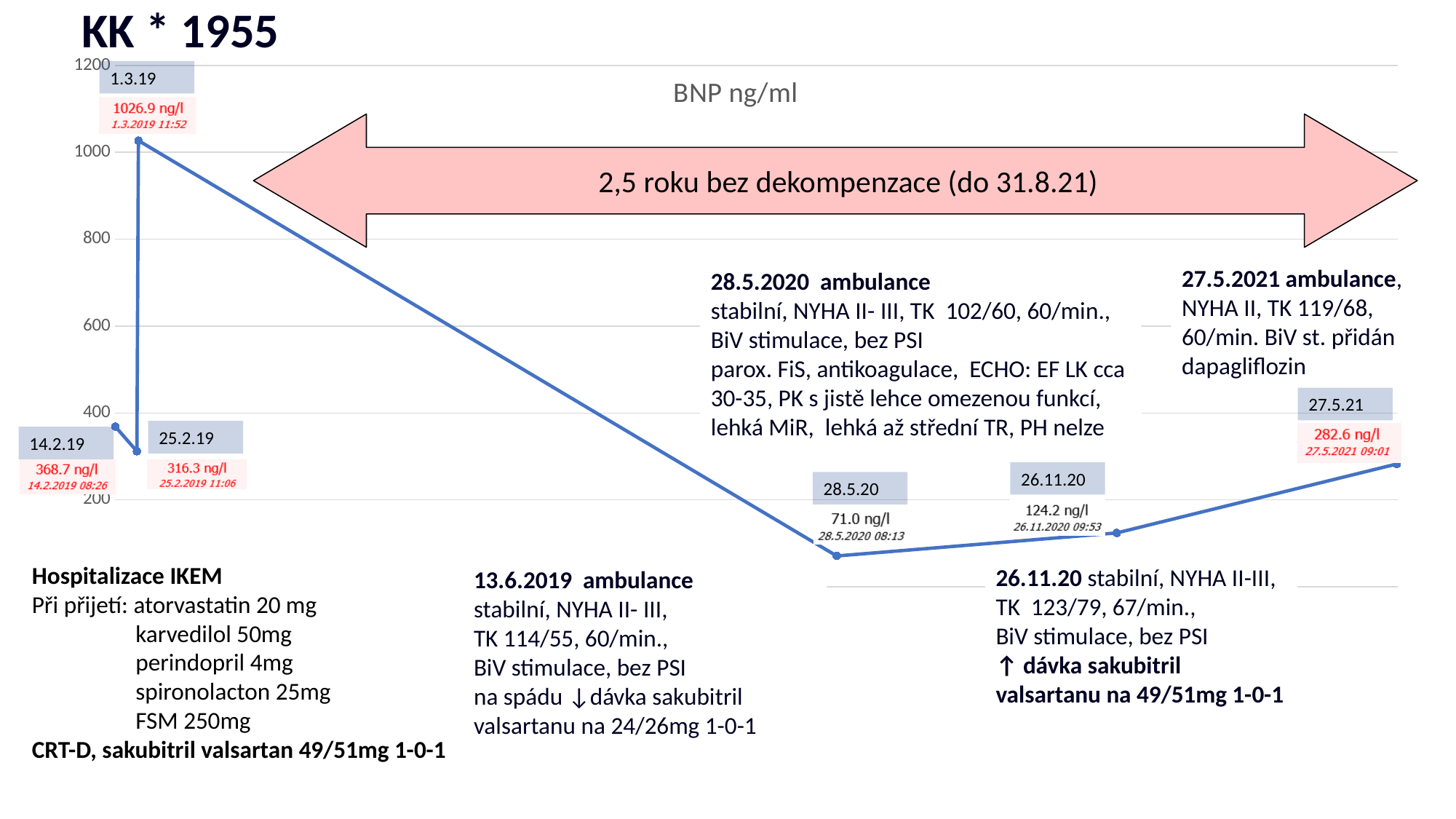
What is the BNP value on 28.5.20? 71.0 ng/l What is the BNP value on 27.5.21? 282.6 ng/l What is the BNP value on 1.3.19? 1026.9 ng/l What kind of chart is shown on the slide? line chart What is the BNP value on 14.2.19? 368.7 ng/l How many data points are plotted on the chart? 6 What is the title of the chart? BNP ng/ml Which is larger, the BNP value on 26.11.20 or on 27.5.21? 27.5.21 On which date is the BNP value highest? 1.3.19 Is the BNP value on 1.3.19 greater or less than 1000? greater On which date is the BNP value lowest? 28.5.20 What is the difference between the BNP values on 14.2.19 and 25.2.19? 52.4 ng/l